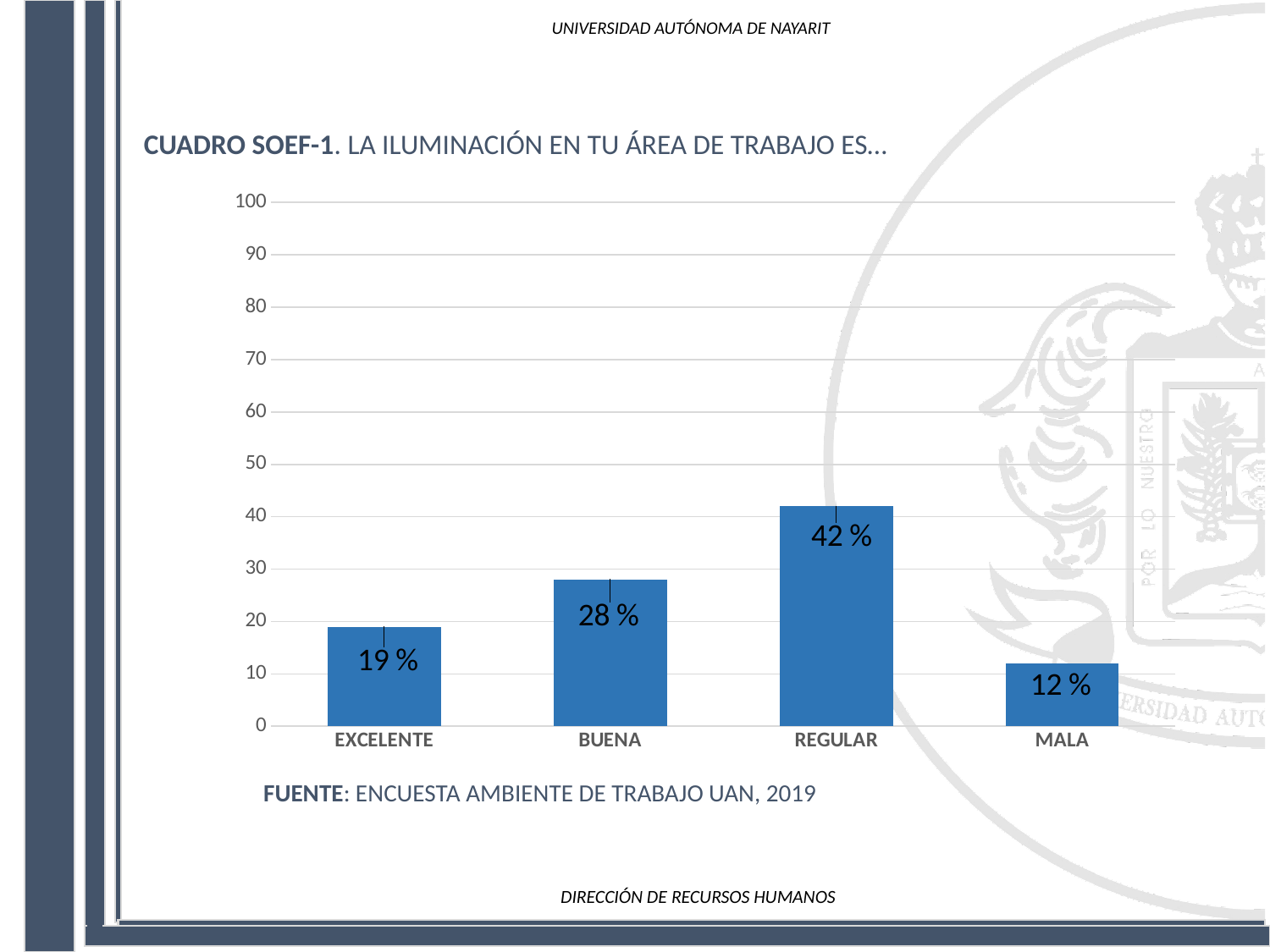
What kind of chart is shown on the slide? bar chart What is the value for REGULAR? 42 % Which category has the lowest value? MALA What is the source cited below the chart? ENCUESTA AMBIENTE DE TRABAJO UAN, 2019 Is the value for BUENA greater or less than 30? less What is the value for EXCELENTE? 19 % Which is larger, the value for BUENA or the value for EXCELENTE? BUENA Which category has the highest value? REGULAR What is the value for MALA? 12 % What is the highest value shown on the y axis? 100 What is the difference between the values for REGULAR and BUENA? 14 % How many categories are shown on the x axis? 4